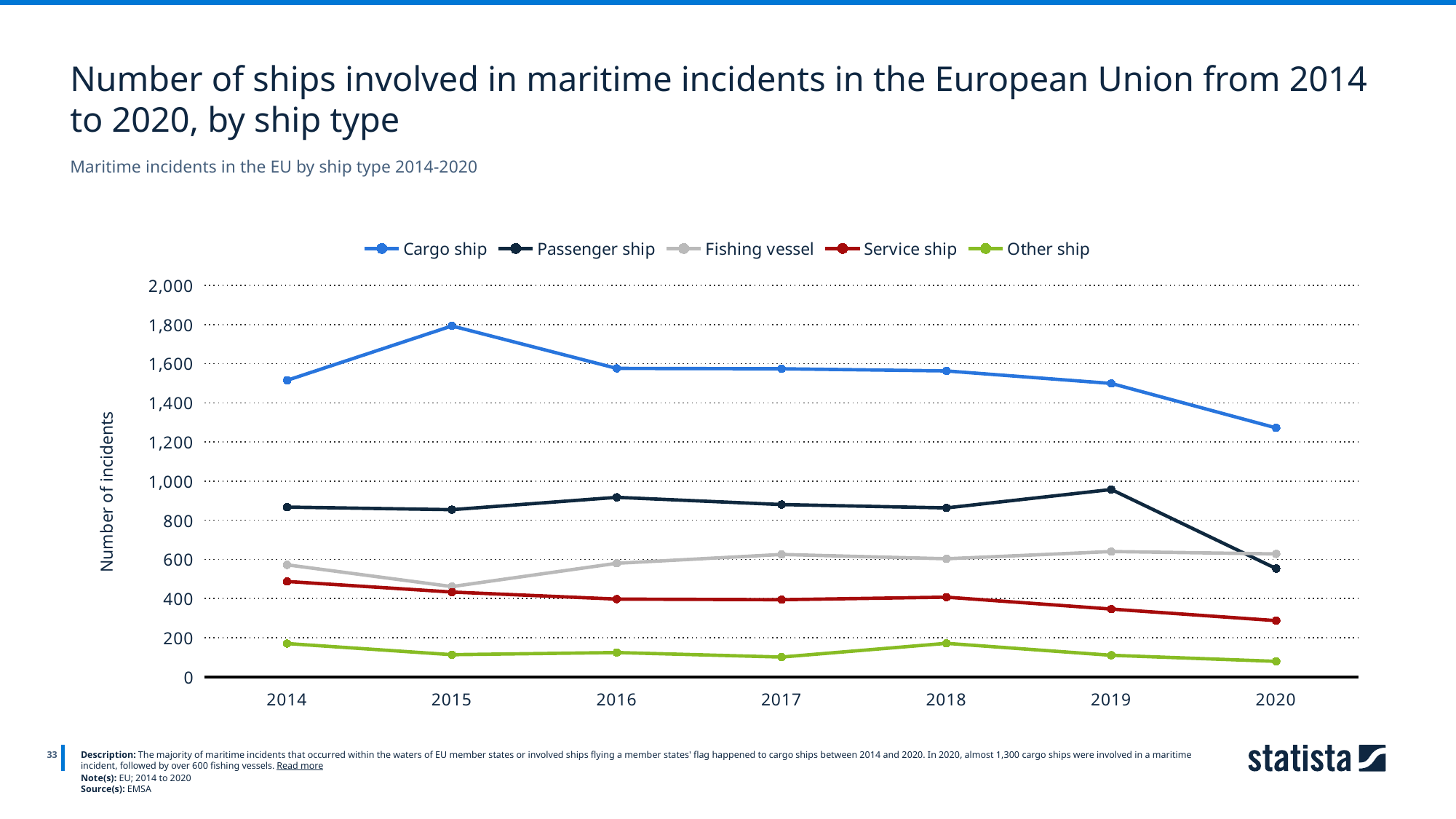
What kind of chart is shown on the slide? line chart How many series does the legend list? 5 In 2020, which is larger: the Fishing vessel value or the Passenger ship value? Fishing vessel Is the value for Passenger ship in 2020 greater or less than 600? less How many years are plotted along the x axis? 7 In which year does the Cargo ship series reach its highest value? 2015 Is the value for Cargo ship in 2015 greater or less than 1,600? greater What is the label on the y axis? Number of incidents In which year does the Cargo ship series reach its lowest value? 2020 In which year does the Passenger ship series reach its highest value? 2019 Is the value for Service ship in 2020 greater or less than 400? less Does the Service ship series rise or fall overall from 2014 to 2020? fall